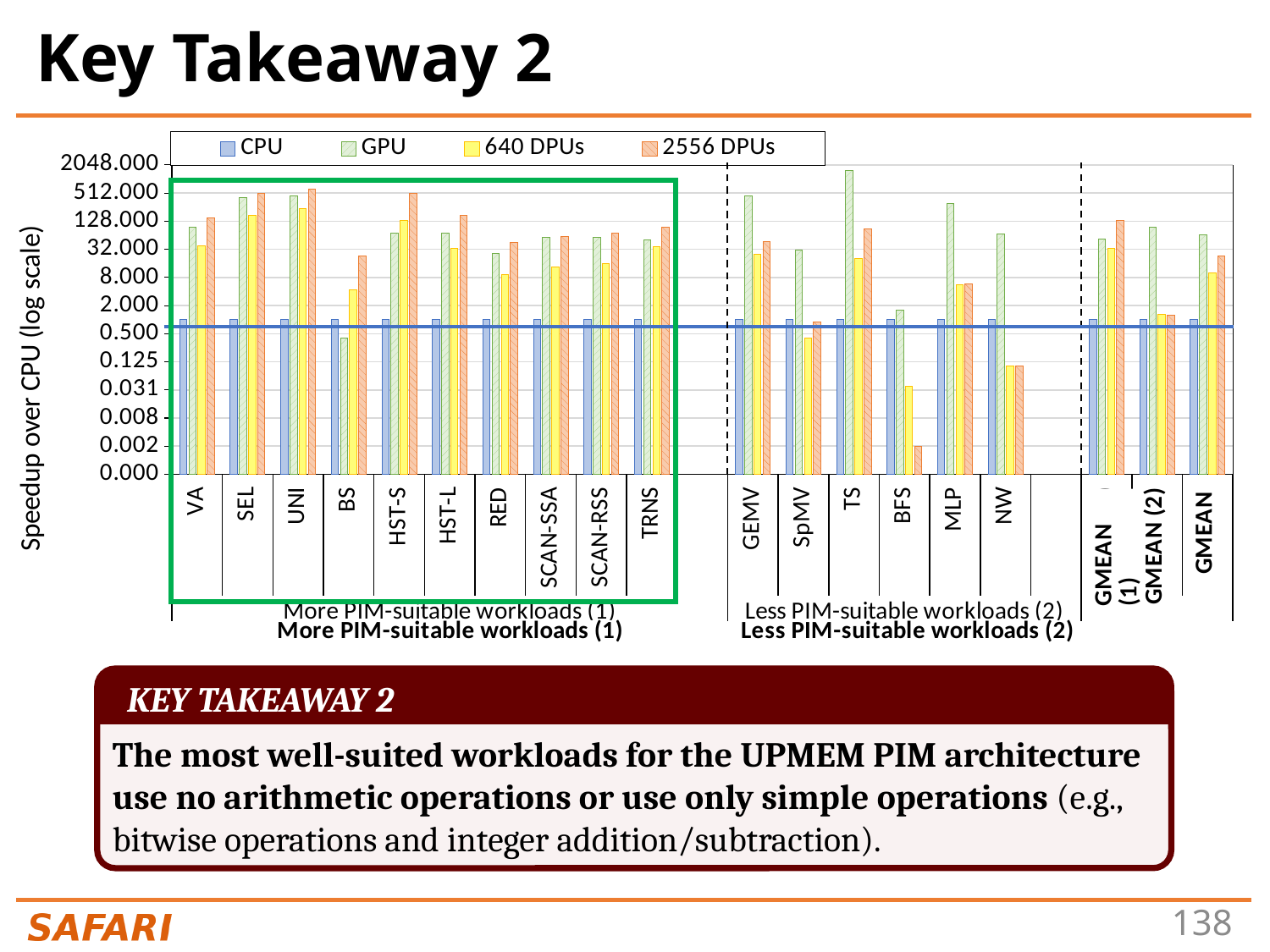
Which workload has the lowest 2556 DPUs bar? BFS What are the series listed in the chart's legend? CPU, GPU, 640 DPUs, 2556 DPUs Is the 640 DPUs value for NW greater or less than 0.500? less Is the 2556 DPUs value for SEL greater or less than 128.000? greater What is the label of the chart's y axis? Speedup over CPU (log scale) What kind of chart is shown on the slide? bar chart Which workload has the highest GPU bar? TS Is the 2556 DPUs value for BFS greater or less than 0.008? less How many series does the chart's legend list? 4 For BS, which is larger: the GPU value or the 2556 DPUs value? 2556 DPUs For GEMV, which is larger: the GPU value or the 2556 DPUs value? GPU